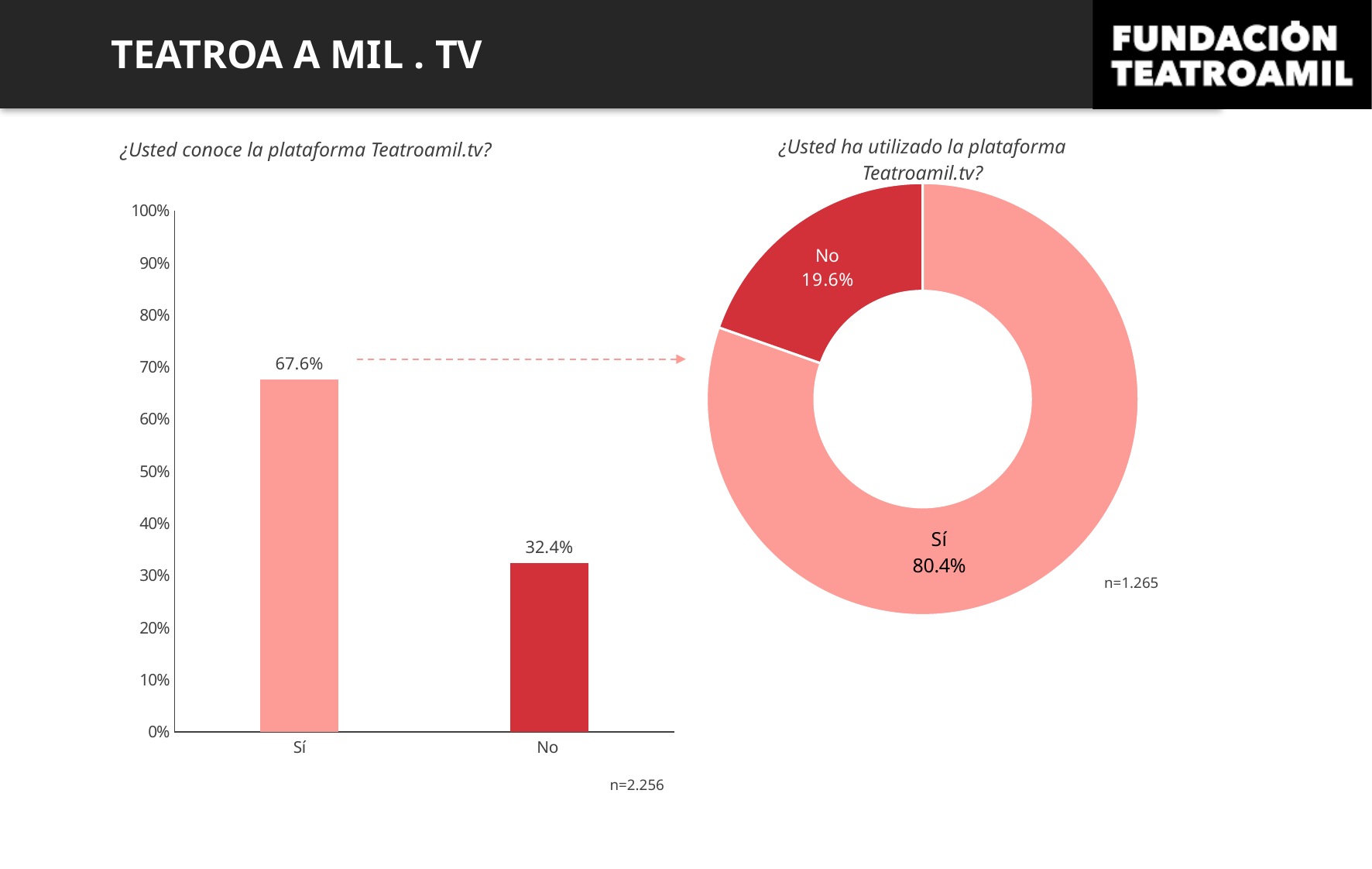
In the bar chart '¿Usted conoce la plataforma Teatroamil.tv?', what is the value for Sí? 67.6% In the donut chart '¿Usted ha utilizado la plataforma Teatroamil.tv?', which slice is the smallest? No What kind of chart is the one on the left of the slide? Bar chart What kind of chart is the one on the right of the slide? Donut (pie) chart What sample size (n) is shown for the donut chart on the right? n=1.265 In the donut chart '¿Usted ha utilizado la plataforma Teatroamil.tv?', what share does Sí have? 80.4% In the bar chart '¿Usted conoce la plataforma Teatroamil.tv?', what is the value for No? 32.4% In the bar chart '¿Usted conoce la plataforma Teatroamil.tv?', what is the difference between the Sí and No values? 35.2% In the bar chart '¿Usted conoce la plataforma Teatroamil.tv?', how many categories are shown? 2 In the bar chart '¿Usted conoce la plataforma Teatroamil.tv?', which category has the highest value? Sí In the donut chart '¿Usted ha utilizado la plataforma Teatroamil.tv?', what is the difference between the Sí and No shares? 60.8% In the donut chart '¿Usted ha utilizado la plataforma Teatroamil.tv?', what share does No have? 19.6%